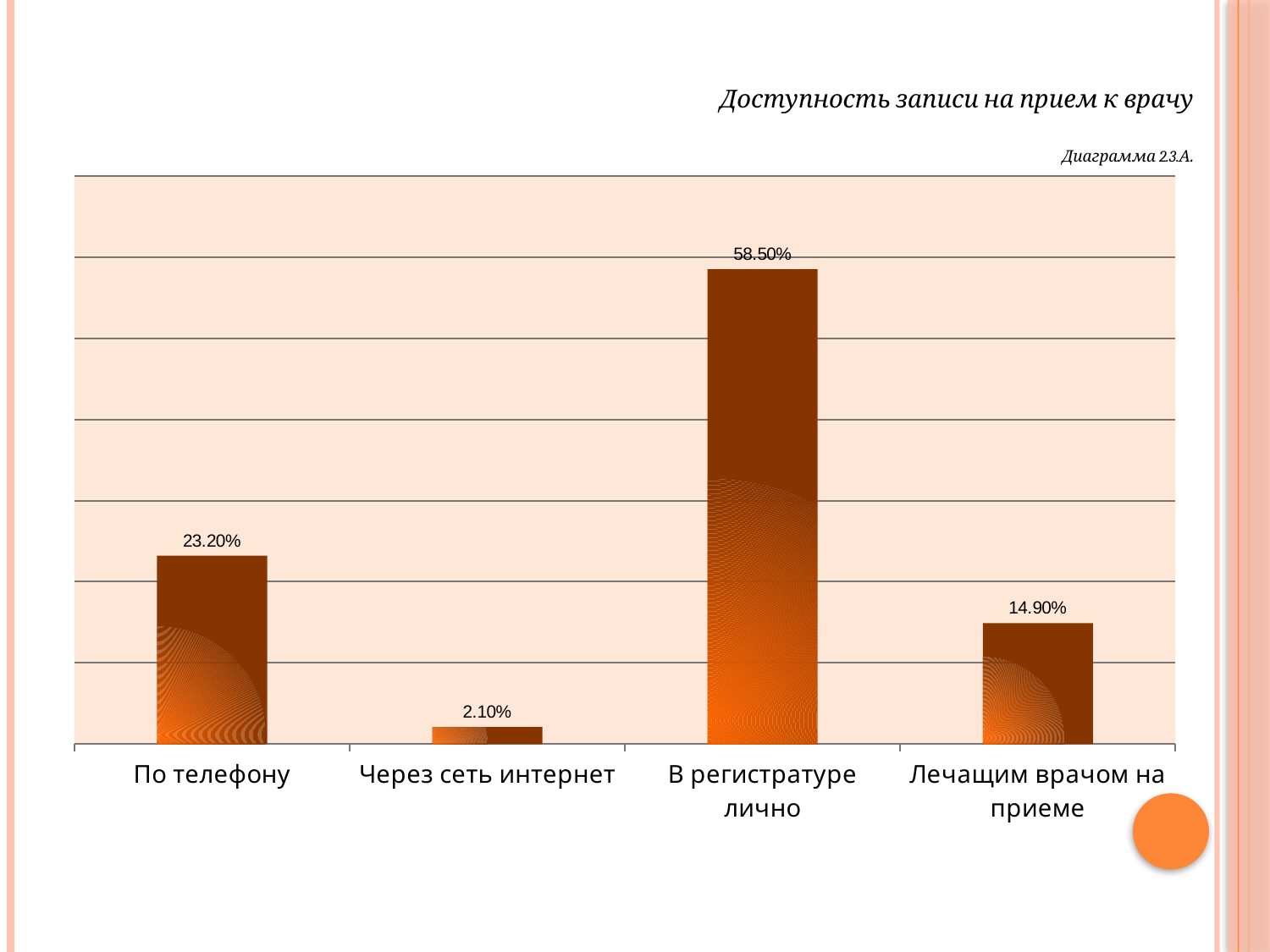
What is the value for "Лечащим врачом на приеме"? 14.90% Which category has the highest value? В регистратуре лично What is the value for "По телефону"? 23.20% Which is larger, the value for "По телефону" or the value for "Лечащим врачом на приеме"? По телефону What is the value for "Через сеть интернет"? 2.10% What is the difference between the values for "В регистратуре лично" and "По телефону"? 35.30% What is the title of the chart? Доступность записи на прием к врачу What is the value for "В регистратуре лично"? 58.50% What kind of chart is shown on the slide? Bar chart How many categories are shown on the chart? 4 What is the difference between the values for "По телефону" and "Лечащим врачом на приеме"? 8.30% Which category has the lowest value? Через сеть интернет